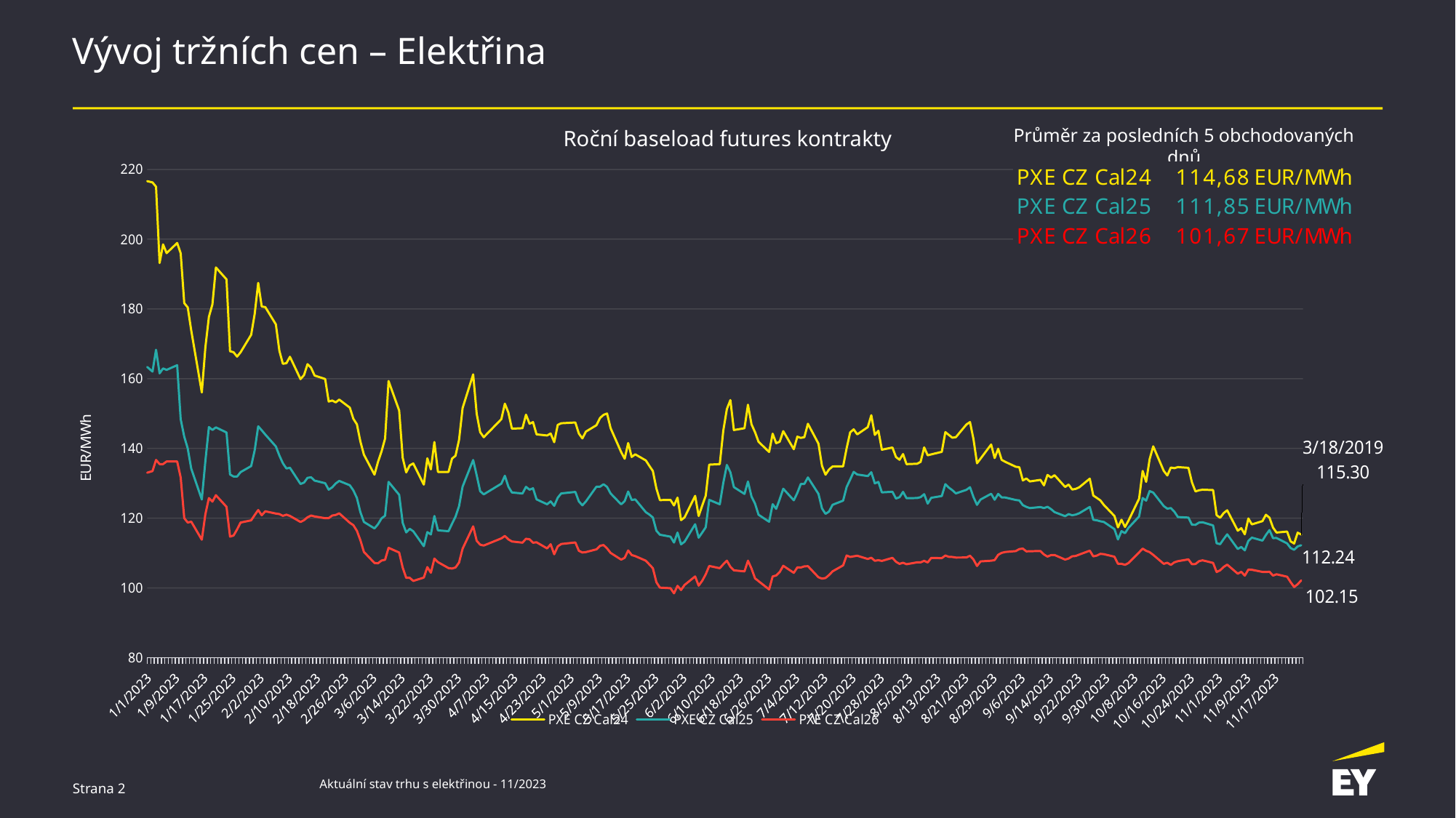
How many series does the chart legend list? 3 Which series is higher at 1/1/2023, PXE CZ Cal24 or PXE CZ Cal26? PXE CZ Cal24 What is the difference between the final labelled values of PXE CZ Cal24 and PXE CZ Cal26? 13.15 Is the value of PXE CZ Cal24 at 1/1/2023 greater or less than 200? greater What is the difference between the final labelled values of PXE CZ Cal24 and PXE CZ Cal25? 3.06 What is the final labelled value of the PXE CZ Cal26 series? 102.15 What kind of chart is shown on the slide? line chart What is the final labelled value of the PXE CZ Cal25 series? 112.24 Which series has the lowest value at the end of the chart? PXE CZ Cal26 Does the PXE CZ Cal24 series generally rise or fall from 1/1/2023 to 11/17/2023? fall What is the final labelled value of the PXE CZ Cal24 series? 115.30 What is the title of the chart? Roční baseload futures kontrakty